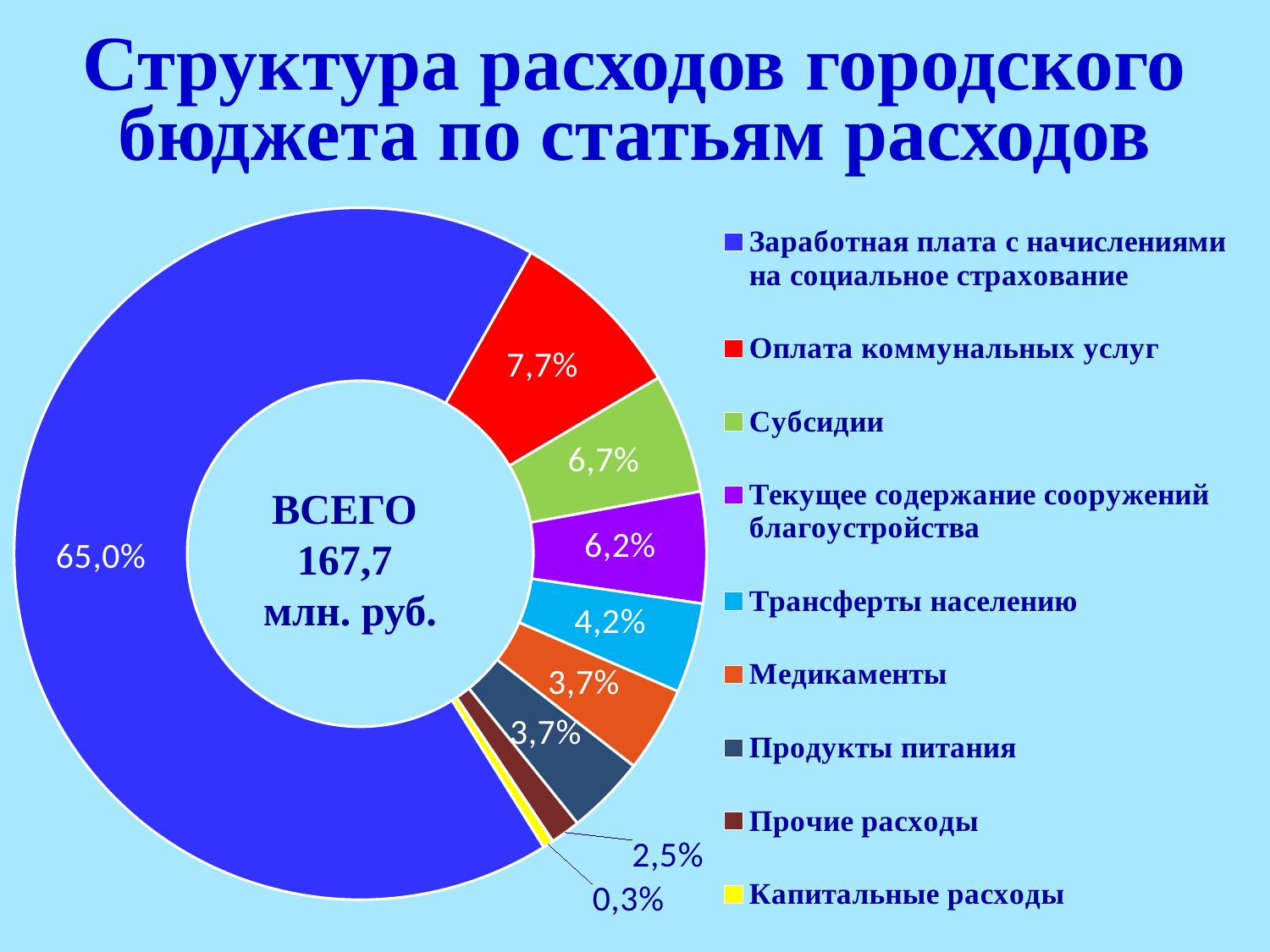
Which expenditure item has the smallest share? Капитальные расходы What total amount is shown in the centre of the chart? 167,7 млн. руб. What share of expenditure is "Субсидии"? 6,7% What share of expenditure is "Оплата коммунальных услуг"? 7,7% Which is larger: the share for "Текущее содержание сооружений благоустройства" or for "Прочие расходы"? Текущее содержание сооружений благоустройства What share of expenditure is "Трансферты населению"? 4,2% What is the difference in percentage points between "Оплата коммунальных услуг" and "Субсидии"? 1,0% Which expenditure item has the largest share? Заработная плата с начислениями на социальное страхование How many expenditure items does the legend list? 9 What kind of chart is shown on the slide? Doughnut (pie) chart What share of expenditure is "Капитальные расходы"? 0,3% What share of the city budget expenditure goes to "Заработная плата с начислениями на социальное страхование"? 65,0%